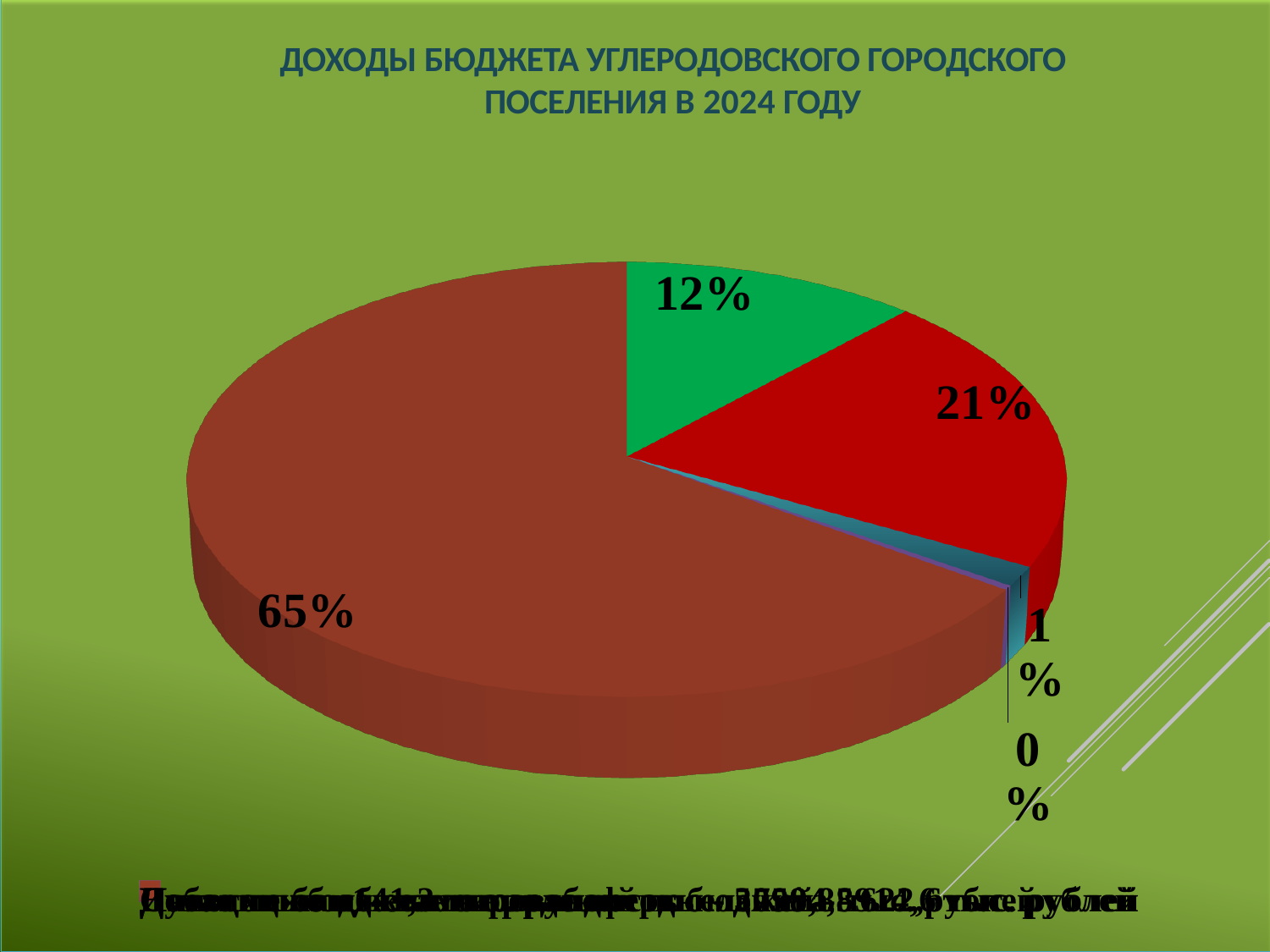
What is the largest percentage label shown on the pie? 65% What share of the pie does the largest slice (brown) have? 65% What colour is the largest slice of the pie? brown What share of the pie does the small blue slice have? 1% How many percentage labels are shown on the pie chart? 5 What share of the pie does the red slice have? 21% What kind of chart is shown on the slide? pie chart Which slice is larger, the red one or the green one? the red one (21%) What is the title of the chart? ДОХОДЫ БЮДЖЕТА УГЛЕРОДОВСКОГО ГОРОДСКОГО ПОСЕЛЕНИЯ В 2024 ГОДУ What is the difference in percentage points between the brown slice (65%) and the red slice (21%)? 44 What is the smallest percentage label shown on the pie? 0%